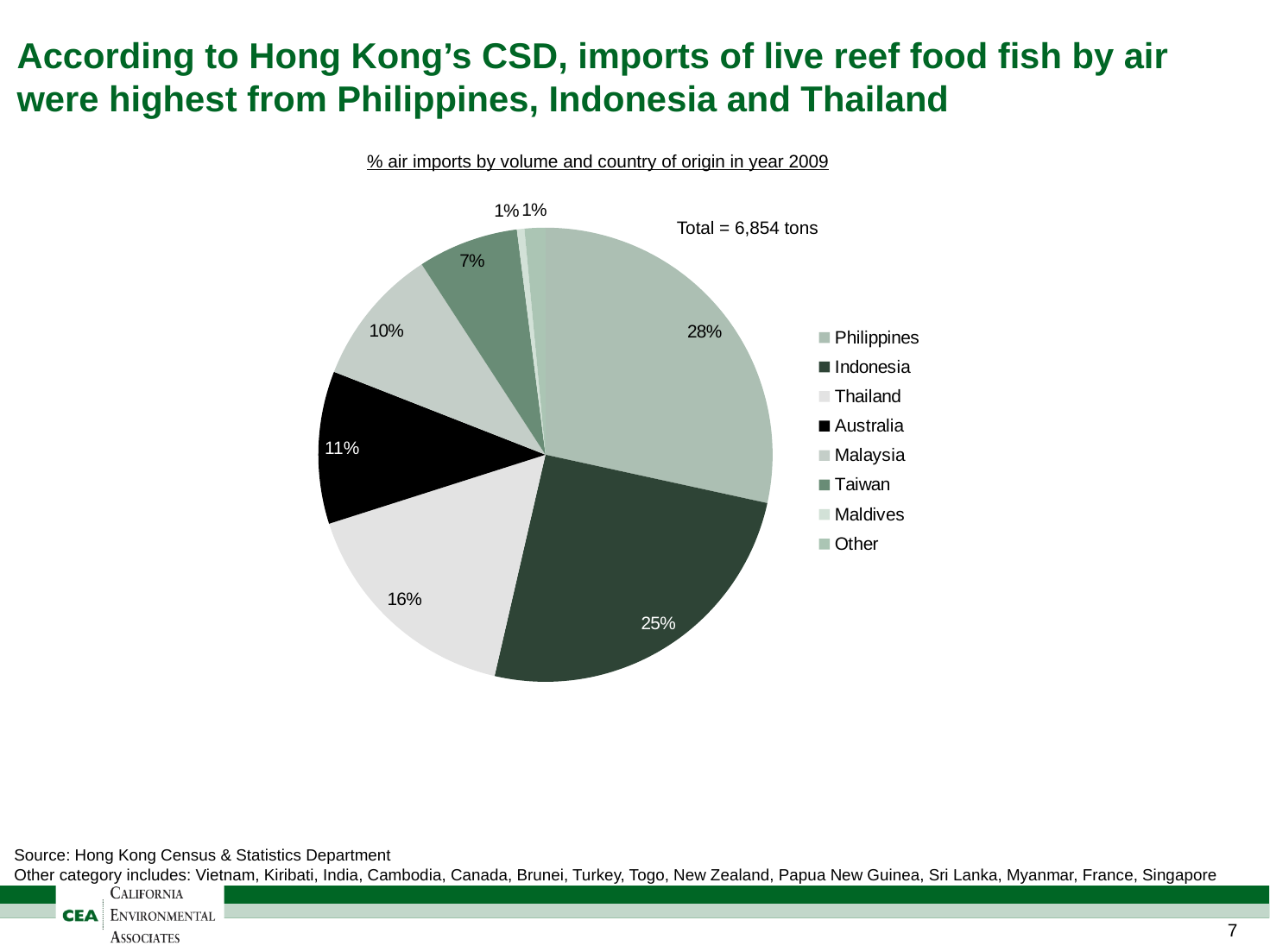
What share of air imports came from Taiwan? 7% What kind of chart is shown on the slide? Pie chart What total volume is stated on the chart? 6,854 tons What is the difference in percentage points between the Philippines' share and Indonesia's share? 3 percentage points How many categories does the legend list? 8 What share of air imports came from Australia? 11% Which has a larger share, Malaysia or Australia? Australia What share of air imports came from Thailand? 16% What is the title of the chart? % air imports by volume and country of origin in year 2009 Which country has the largest share of air imports? Philippines